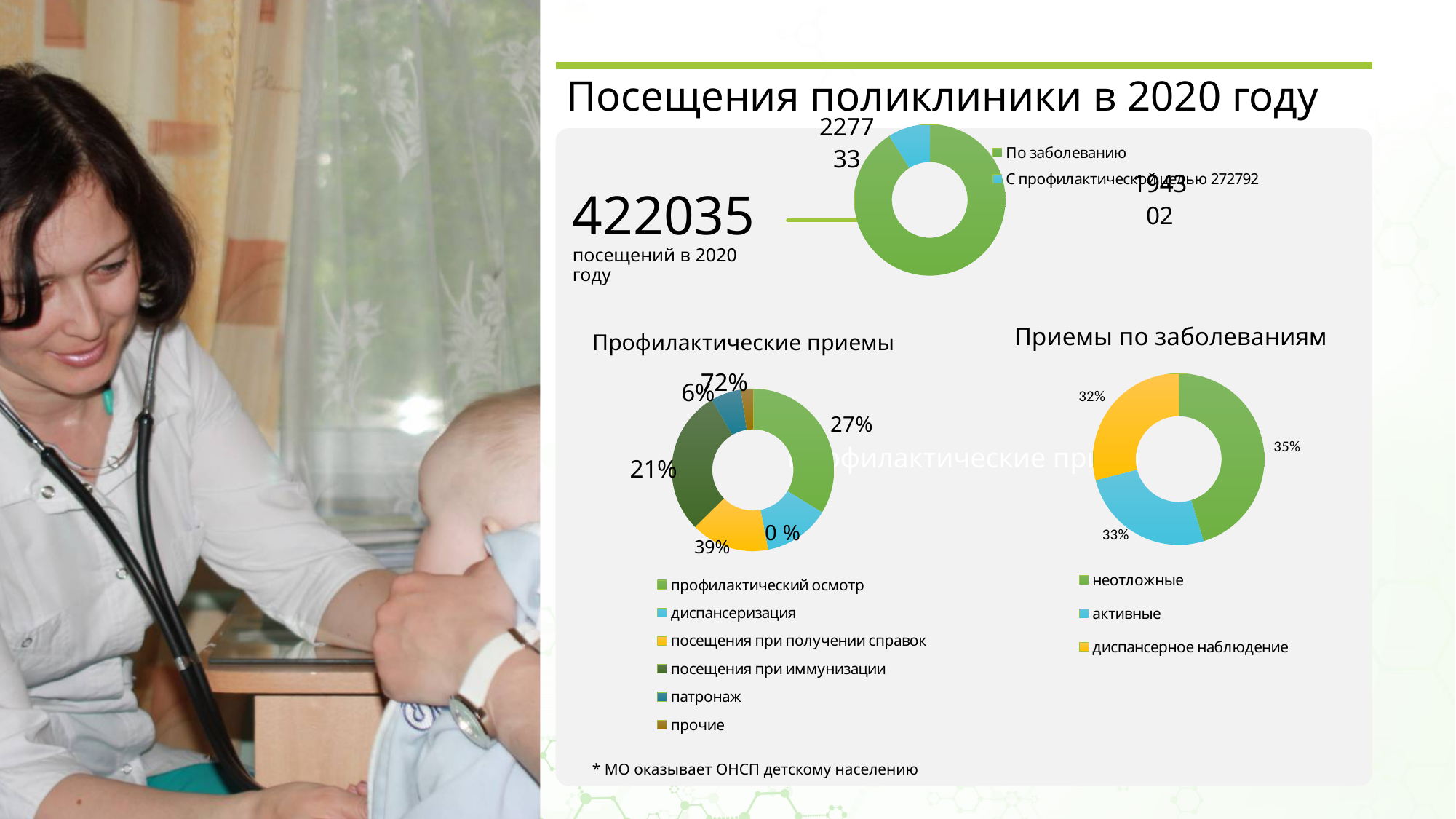
In the 'Приемы по заболеваниям' chart, which category has the largest share? неотложные In the 'Профилактические приемы' chart, which is larger: профилактический осмотр or посещения при иммунизации? профилактический осмотр In the 'Приемы по заболеваниям' chart, what share is labelled for неотложные? 35% How many categories does the legend of the 'Приемы по заболеваниям' chart list? 3 In the top chart next to the number 422035, which of the two categories has the larger slice: По заболеванию or С профилактической целью? По заболеванию In the 'Профилактические приемы' chart, what share is labelled for профилактический осмотр? 27% In the 'Приемы по заболеваниям' chart, what share is labelled for активные? 33% In the 'Профилактические приемы' chart, what share is labelled for посещения при получении справок? 39% How many categories does the legend of the 'Профилактические приемы' chart list? 6 What kind of chart is used for 'Приемы по заболеваниям'? Pie (donut) chart